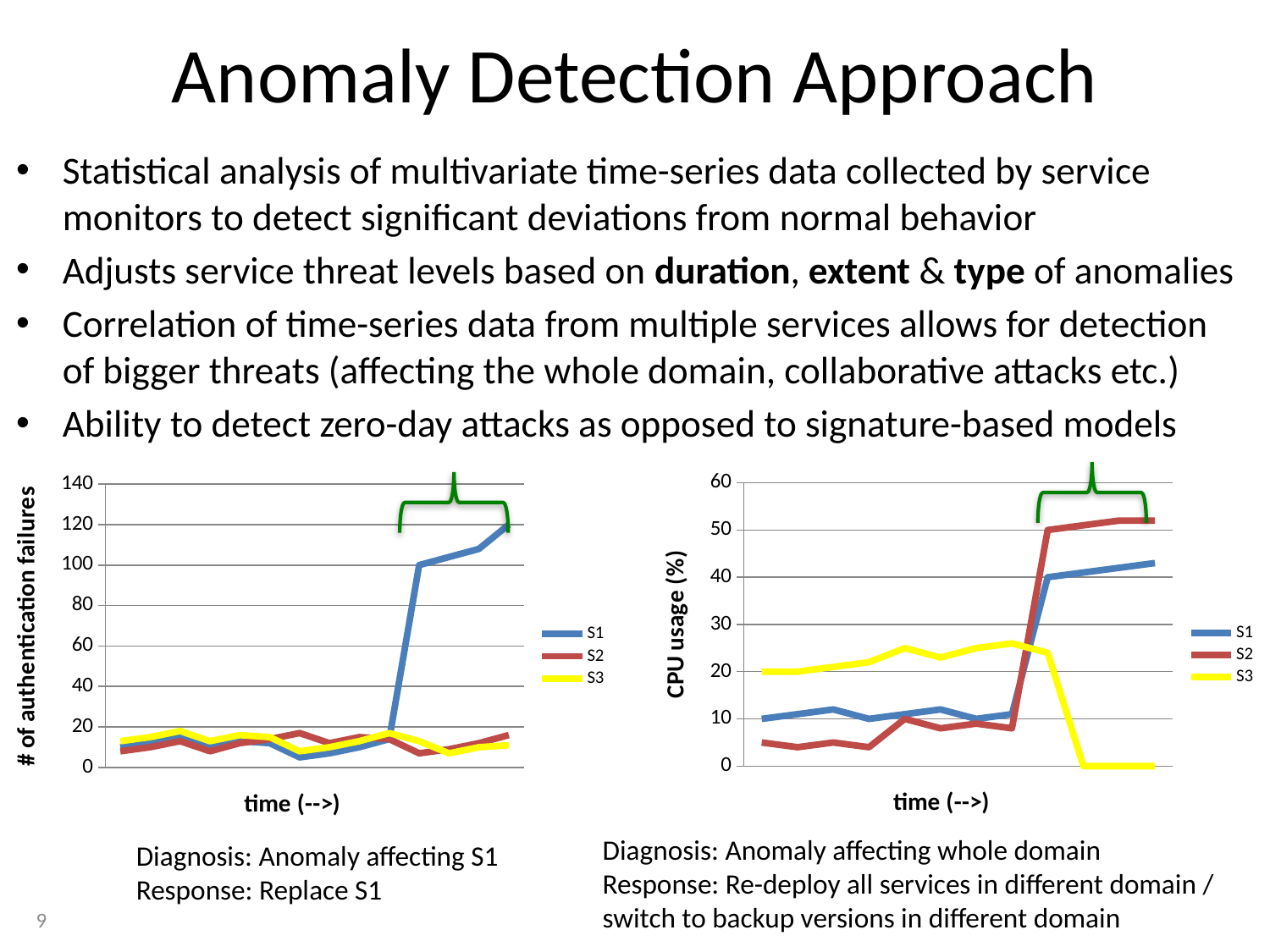
How many series does the legend of the right chart (CPU usage (%)) list? 3 In the right chart (CPU usage (%)), does the S3 series rise or fall at the end of the time axis? fall In the left chart (# of authentication failures), which series has the highest value at the end of the time axis? S1 In the right chart (CPU usage (%)), which series has the higher final value, S1 or S2? S2 In the left chart (# of authentication failures), is the final value of S1 greater or less than 100? greater What kind of chart is the left chart (# of authentication failures)? line chart In the right chart (CPU usage (%)), is the final value of S2 greater or less than 50? greater How many series does the legend of the left chart (# of authentication failures) list? 3 In the left chart (# of authentication failures), is the final value of S3 greater or less than 20? less What is the y-axis title of the left chart? # of authentication failures In the right chart (CPU usage (%)), what is the final value of S3? 0 What kind of chart is the right chart (CPU usage (%))? line chart